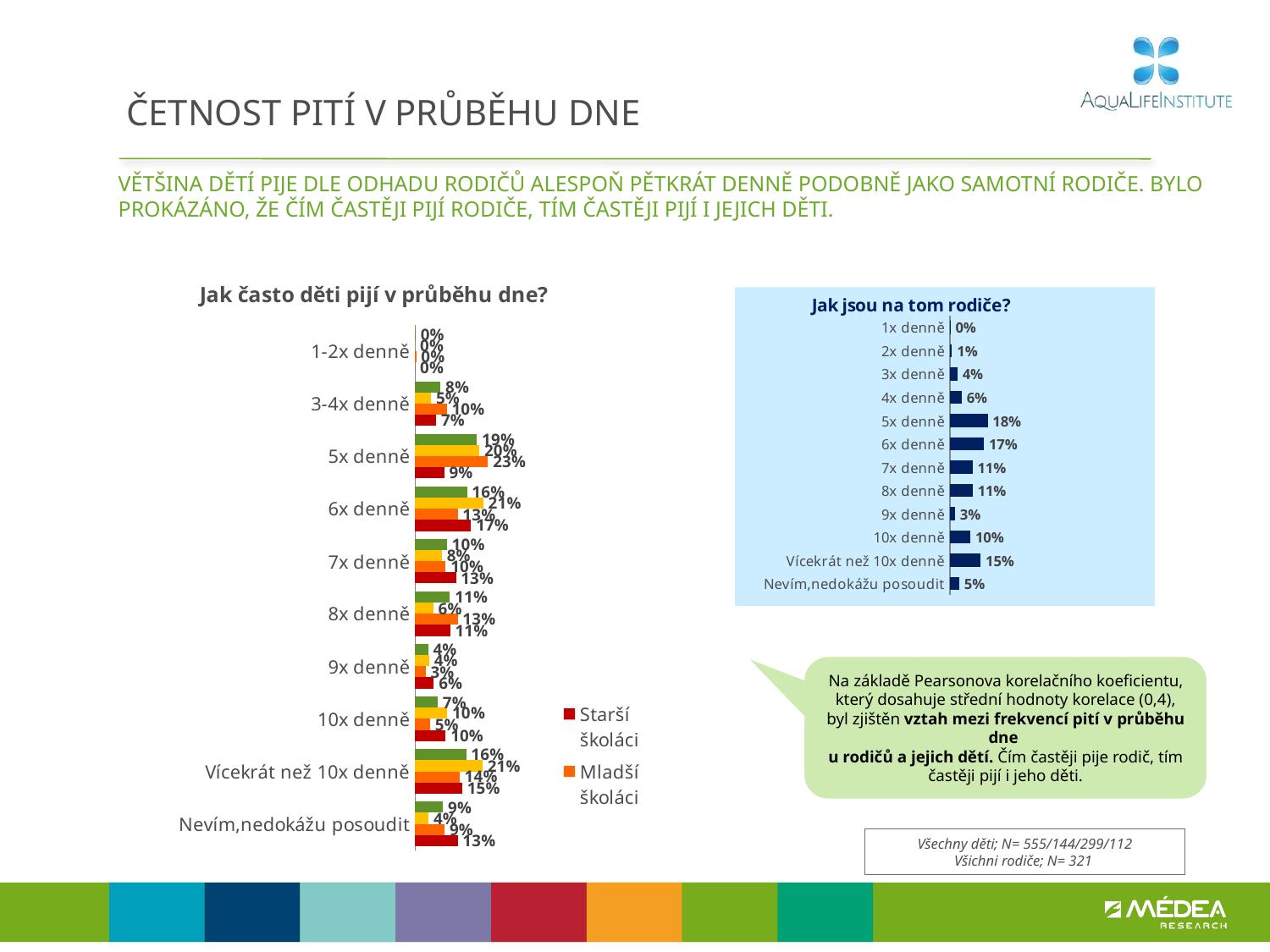
In the chart "Jak často děti pijí v průběhu dne?", what is the value for "Mladší školáci" in the category "5x denně"? 23% In the chart "Jak jsou na tom rodiče?", which category has the lowest value? 1x denně In the chart "Jak často děti pijí v průběhu dne?", what is the value for "Starší školáci" in the category "6x denně"? 17% In the chart "Jak často děti pijí v průběhu dne?", what colour represents "Starší školáci"? Red In the chart "Jak často děti pijí v průběhu dne?", what is the value for "Starší školáci" in the category "Vícekrát než 10x denně"? 15% What kind of chart is "Jak jsou na tom rodiče?"? Bar chart In the chart "Jak jsou na tom rodiče?", what is the value for "Vícekrát než 10x denně"? 15% In the chart "Jak jsou na tom rodiče?", what is the difference between the values for "5x denně" and "9x denně"? 15% In the chart "Jak jsou na tom rodiče?", what is the value for "5x denně"? 18% In the chart "Jak jsou na tom rodiče?", which category has the highest value? 5x denně How many categories does the chart "Jak jsou na tom rodiče?" show? 12 In the chart "Jak jsou na tom rodiče?", which is larger, the value for "6x denně" or the value for "10x denně"? 6x denně